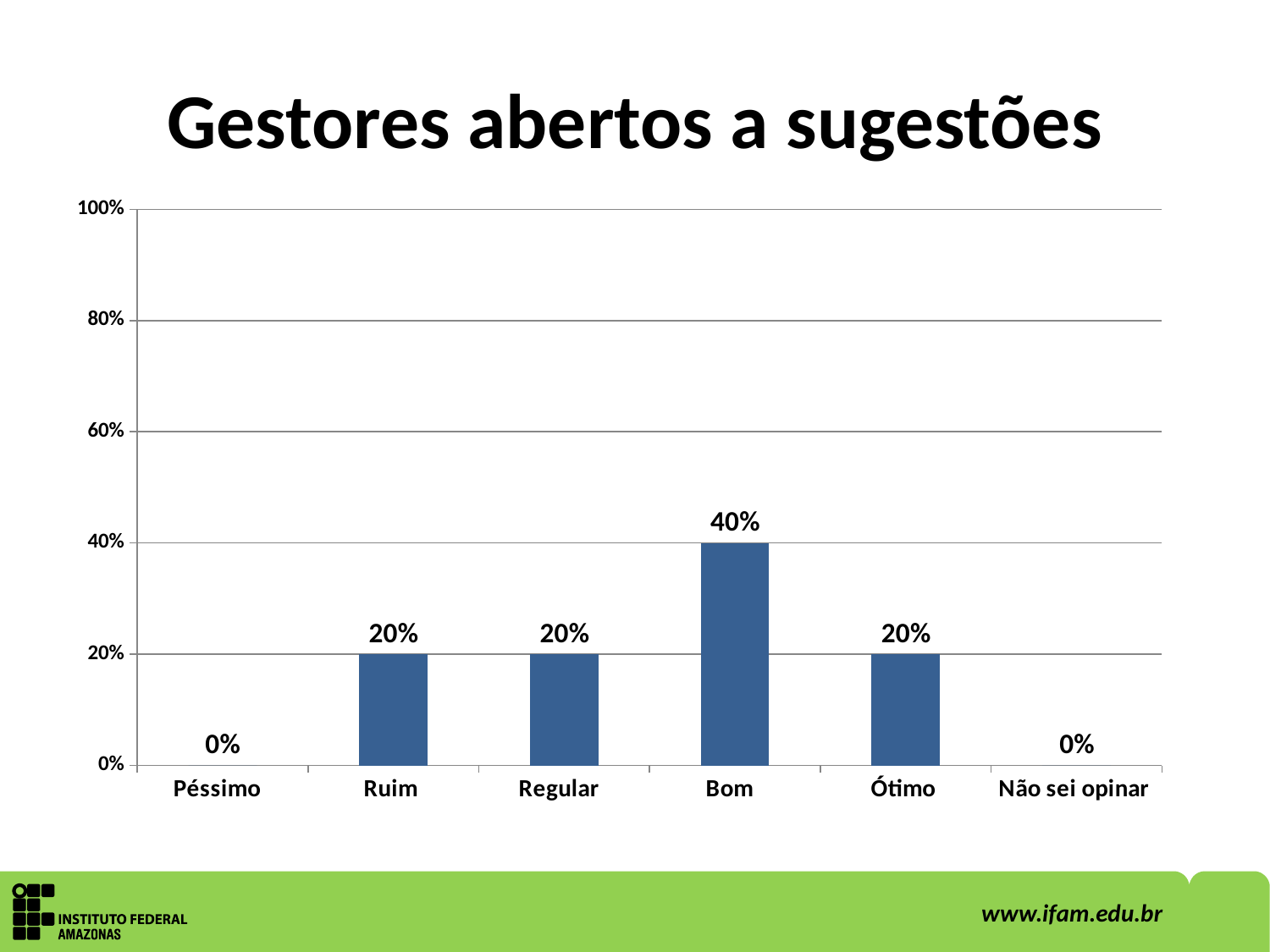
What is the value for Péssimo? 0% How many categories have a value of 20%? 3 Which category has the highest value? Bom Which is larger, the value for Bom or the value for Regular? Bom What is the title of the chart? Gestores abertos a sugestões How many categories are shown on the x axis? 6 What is the value for Bom? 40% What is the value for Não sei opinar? 0% What is the difference between the values for Bom and Ótimo? 20% What is the value for Ruim? 20% Is the value for Bom greater or less than 60%? less What kind of chart is shown on the slide? bar chart